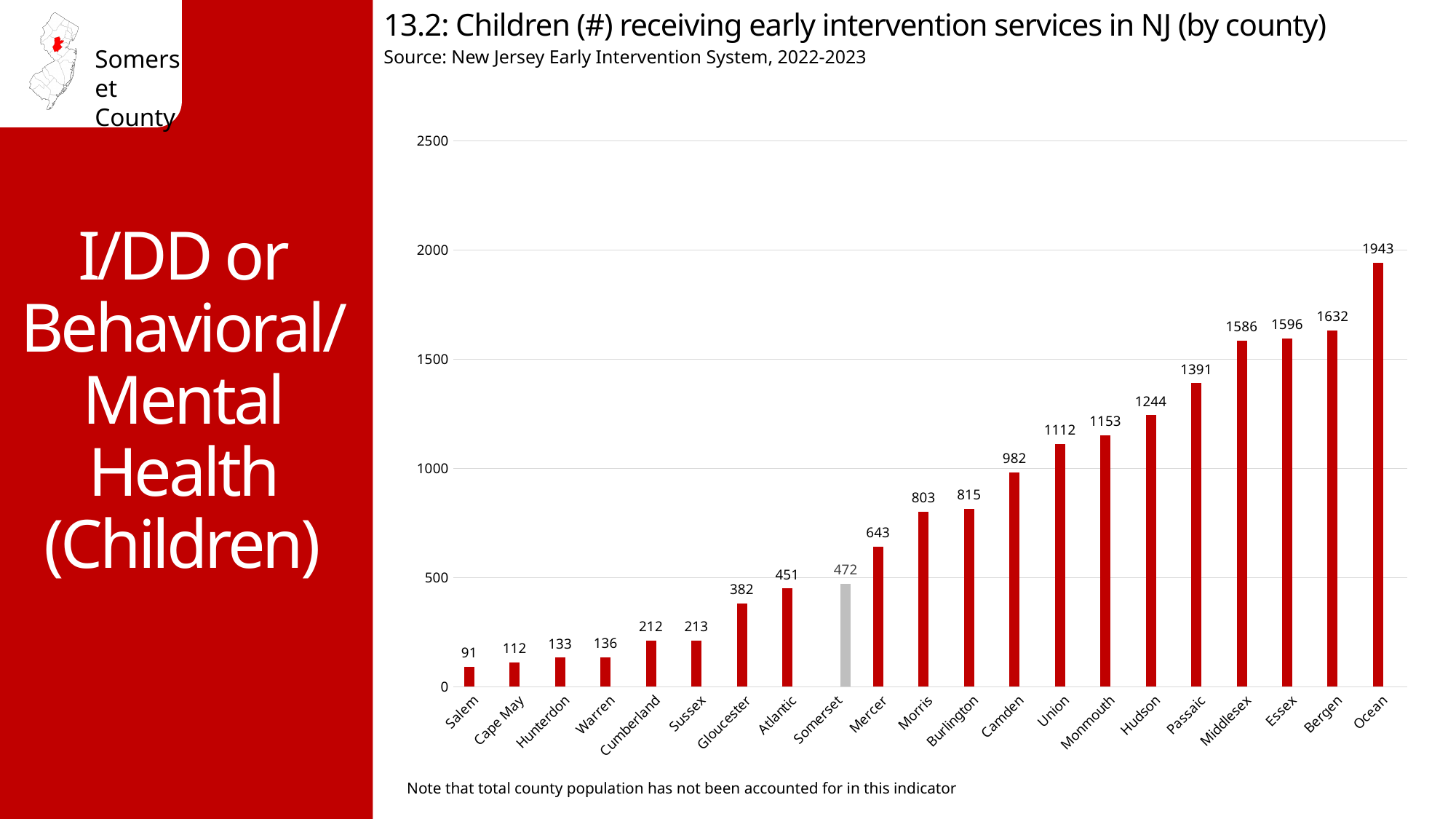
How many children are receiving early intervention services in Somerset County? 472 What is the difference between the values for Mercer and Somerset? 171 Which county has the highest number of children receiving early intervention services? Ocean What kind of chart is shown on the slide? Bar chart How many counties are shown on the x axis? 21 Which county has a larger value, Camden or Union? Union Do the values rise or fall moving from left to right along the x axis? Rise What is the difference between the values for Ocean and Bergen? 311 Is the value for Passaic greater or less than 1500? less What is the value shown for Hudson County? 1244 Which county's bar is coloured grey instead of red? Somerset Which county has the lowest number of children receiving early intervention services? Salem